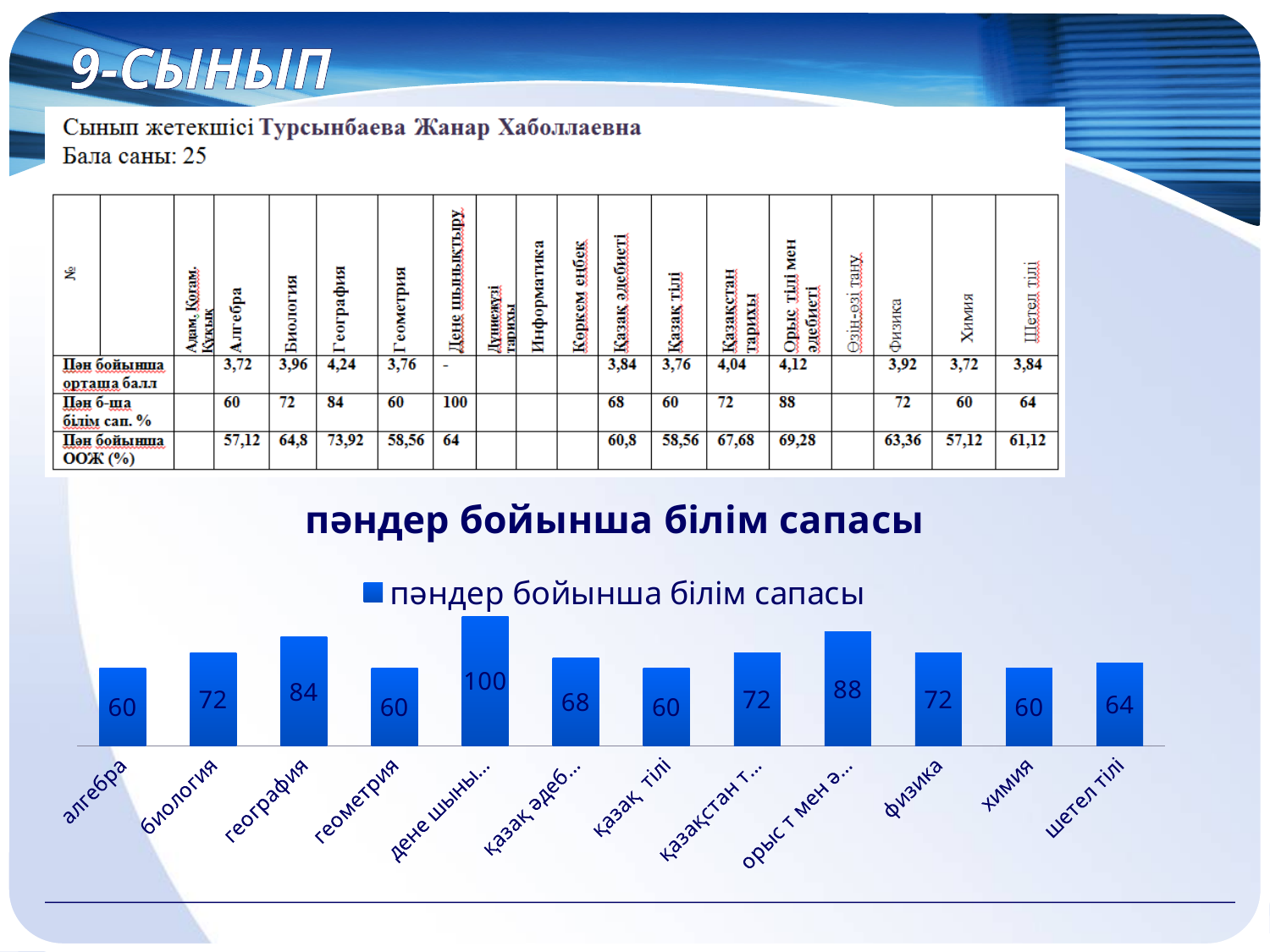
What kind of chart is shown on the slide? bar chart What is the title of the chart? пәндер бойынша білім сапасы Which is larger, the value for физика or the value for химия? физика What is the value for география in the chart? 84 What is the value for физика in the chart? 72 How many categories are shown on the x axis of the chart? 12 How many series does the chart legend list? 1 Which category has the highest value in the chart? дене шынықтыру What is the difference between the values for биология and шетел тілі? 8 What is the value for биология in the chart? 72 What is the value for шетел тілі in the chart? 64 What is the difference between the values for география and алгебра? 24